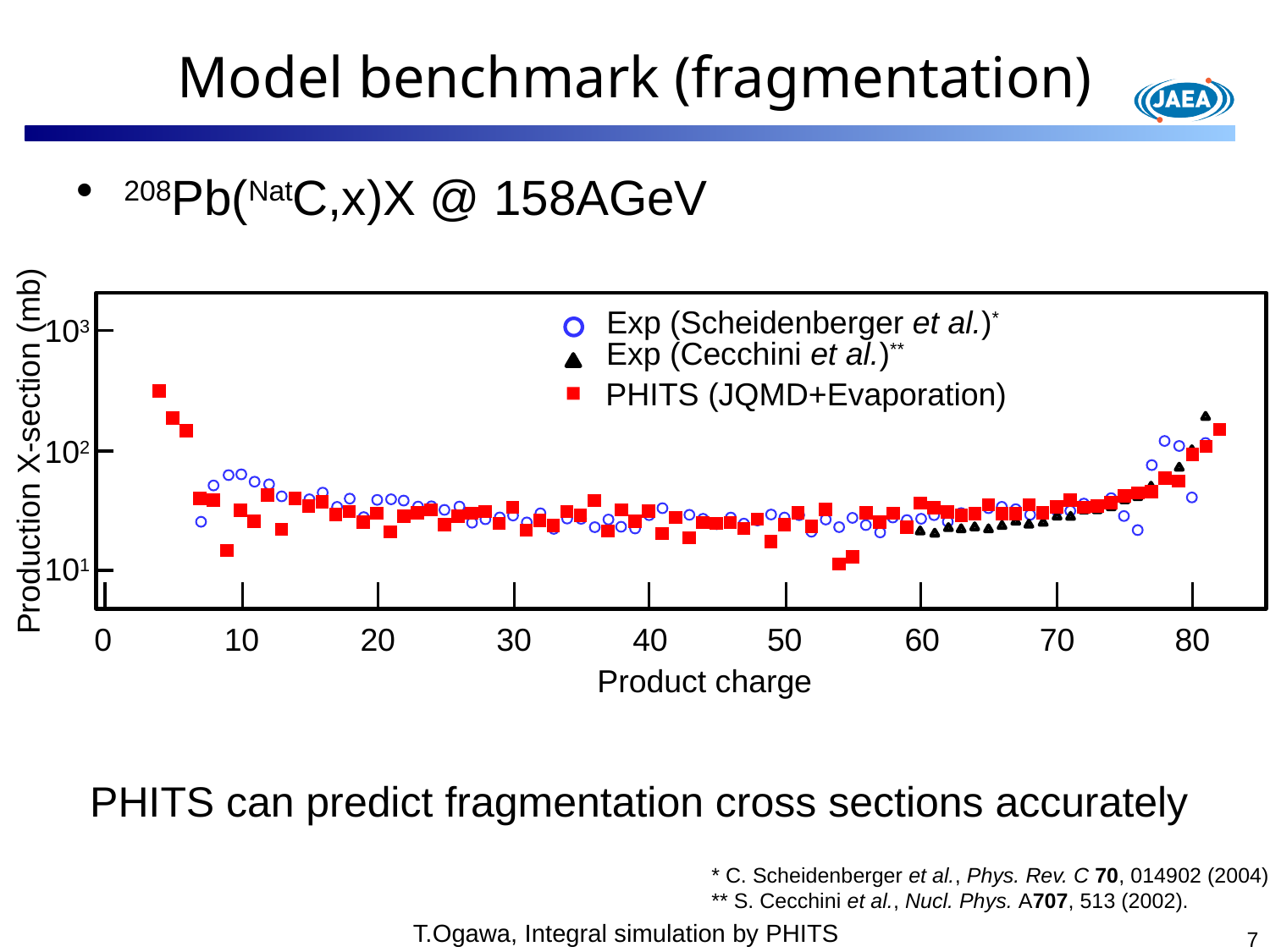
Is the PHITS (JQMD+Evaporation) value at product charge 45 greater or less than 100? less What is the label of the x axis of the chart? Product charge Is the Exp (Cecchini et al.) value at product charge 62 greater or less than 100? less How many series does the chart legend list? 3 Do the PHITS (JQMD+Evaporation) values rise or fall as product charge increases from 60 to 80? rise Is the Exp (Cecchini et al.) value at product charge 81 greater or less than 100? greater What is the label of the y axis of the chart? Production X-section (mb) Which series has the highest plotted point on the chart? PHITS (JQMD+Evaporation) What kind of chart is shown on the slide? Scatter plot Do the PHITS (JQMD+Evaporation) values rise or fall as product charge increases from 4 to 10? fall Which series in the legend is plotted with red squares? PHITS (JQMD+Evaporation)